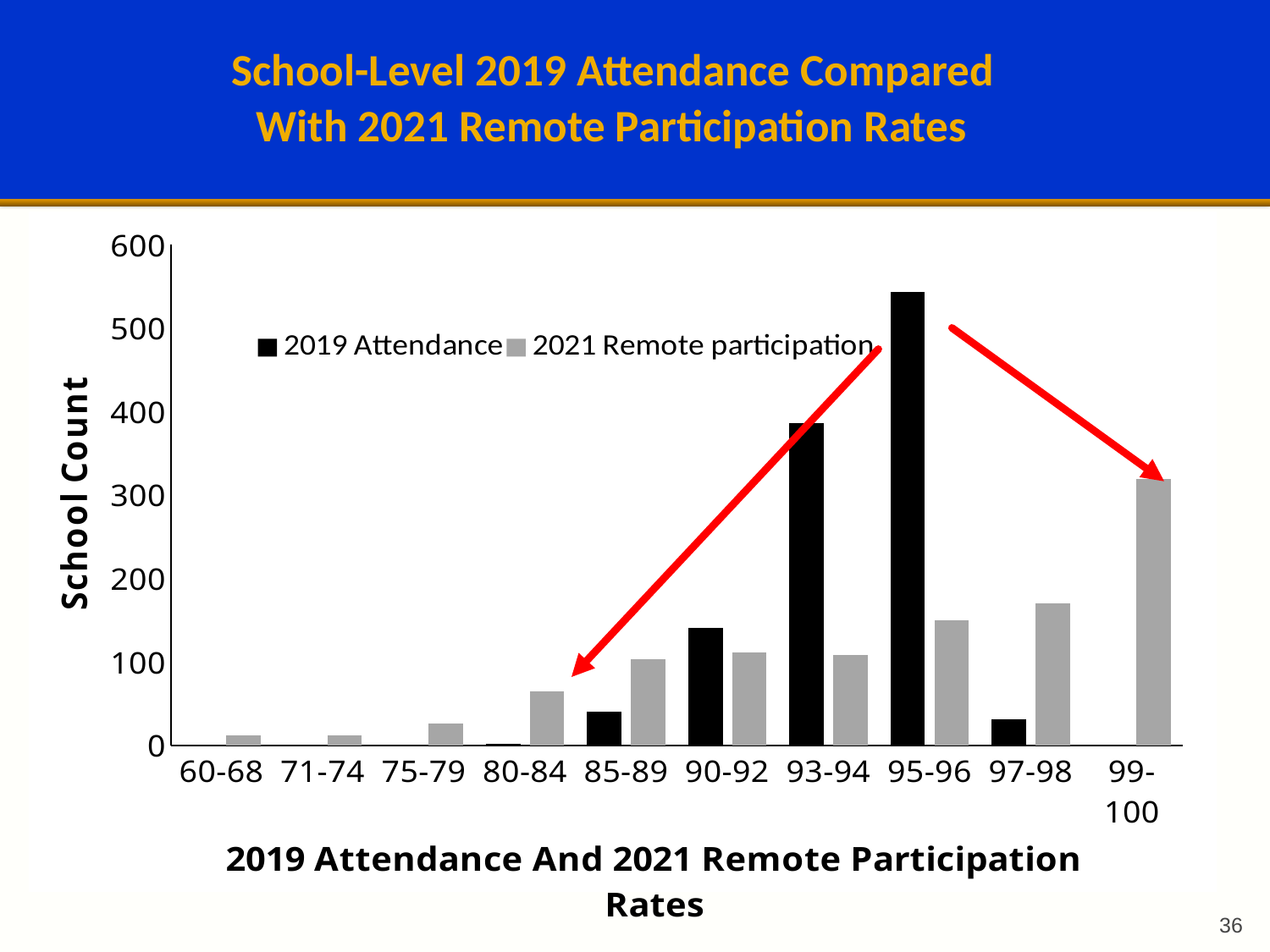
Is the 2019 Attendance value for 95-96 greater or less than 500? greater Is the 2021 Remote participation value for 97-98 greater or less than 200? less Which category has the highest 2021 Remote participation school count? 99-100 For the 93-94 category, which series has the larger school count, 2019 Attendance or 2021 Remote participation? 2019 Attendance What kind of chart is shown on the slide? bar chart For the 99-100 category, which series has the larger school count, 2019 Attendance or 2021 Remote participation? 2021 Remote participation How many series does the legend list? 2 How many attendance-rate categories are shown on the x axis? 10 What is the label on the vertical axis of the chart? School Count Which category has the highest 2019 Attendance school count? 95-96